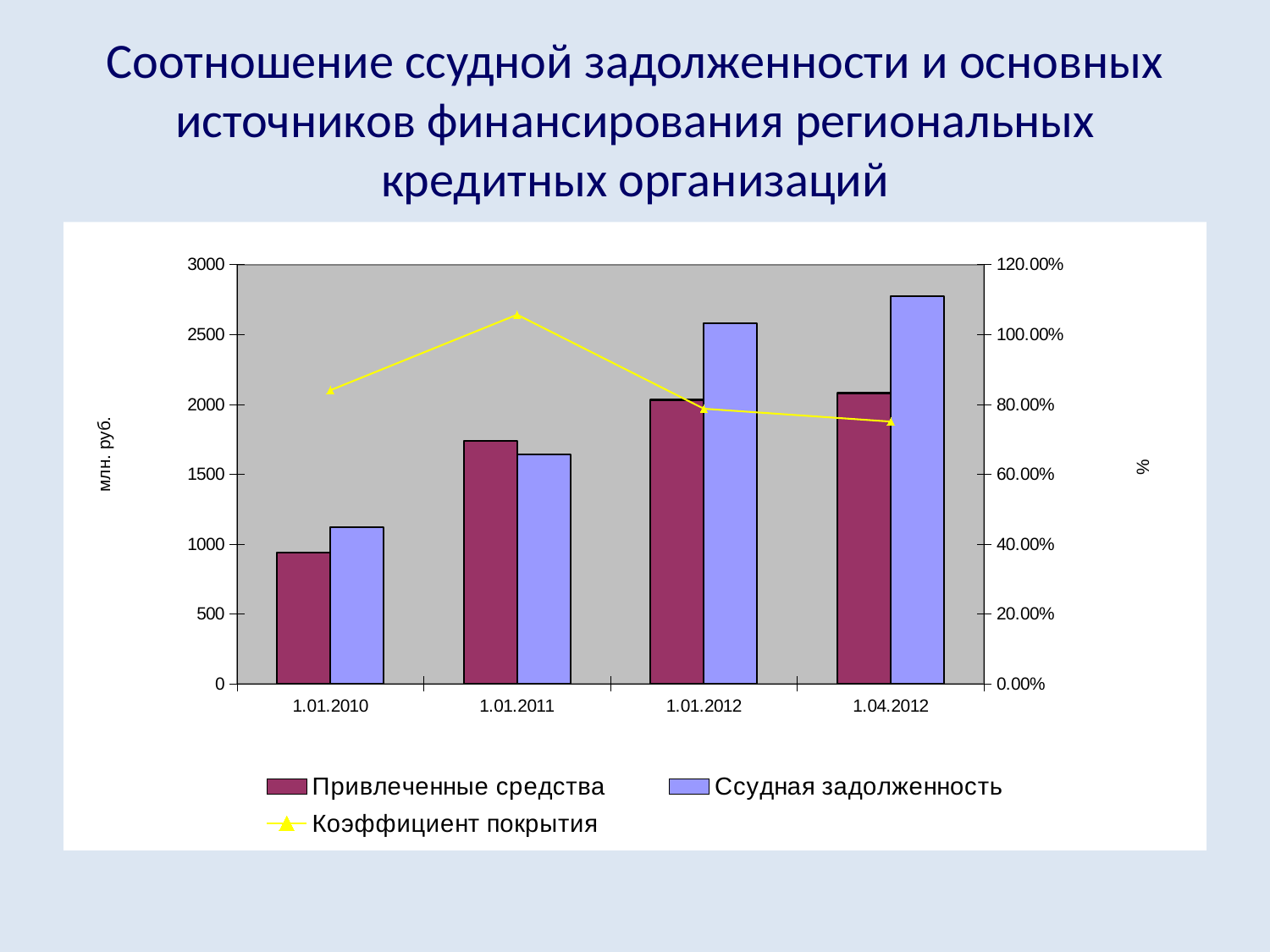
Is the value of Коэффициент покрытия for 1.01.2011 greater or less than 100.00%? greater Is the value of Ссудная задолженность for 1.01.2012 greater or less than 2500? greater On which date is Привлеченные средства the lowest? 1.01.2010 For 1.01.2011, which is larger: Привлеченные средства or Ссудная задолженность? Привлеченные средства What kind of chart is shown on the slide? Combined bar and line chart On which date is Коэффициент покрытия the highest? 1.01.2011 How many dates are shown on the x axis of the chart? 4 How many series does the chart legend list? 3 Does Ссудная задолженность rise or fall from 1.01.2010 to 1.04.2012? rises Is the value of Привлеченные средства for 1.01.2010 greater or less than 1000? less On which date is Ссудная задолженность the highest? 1.04.2012 On which date is Коэффициент покрытия the lowest? 1.04.2012